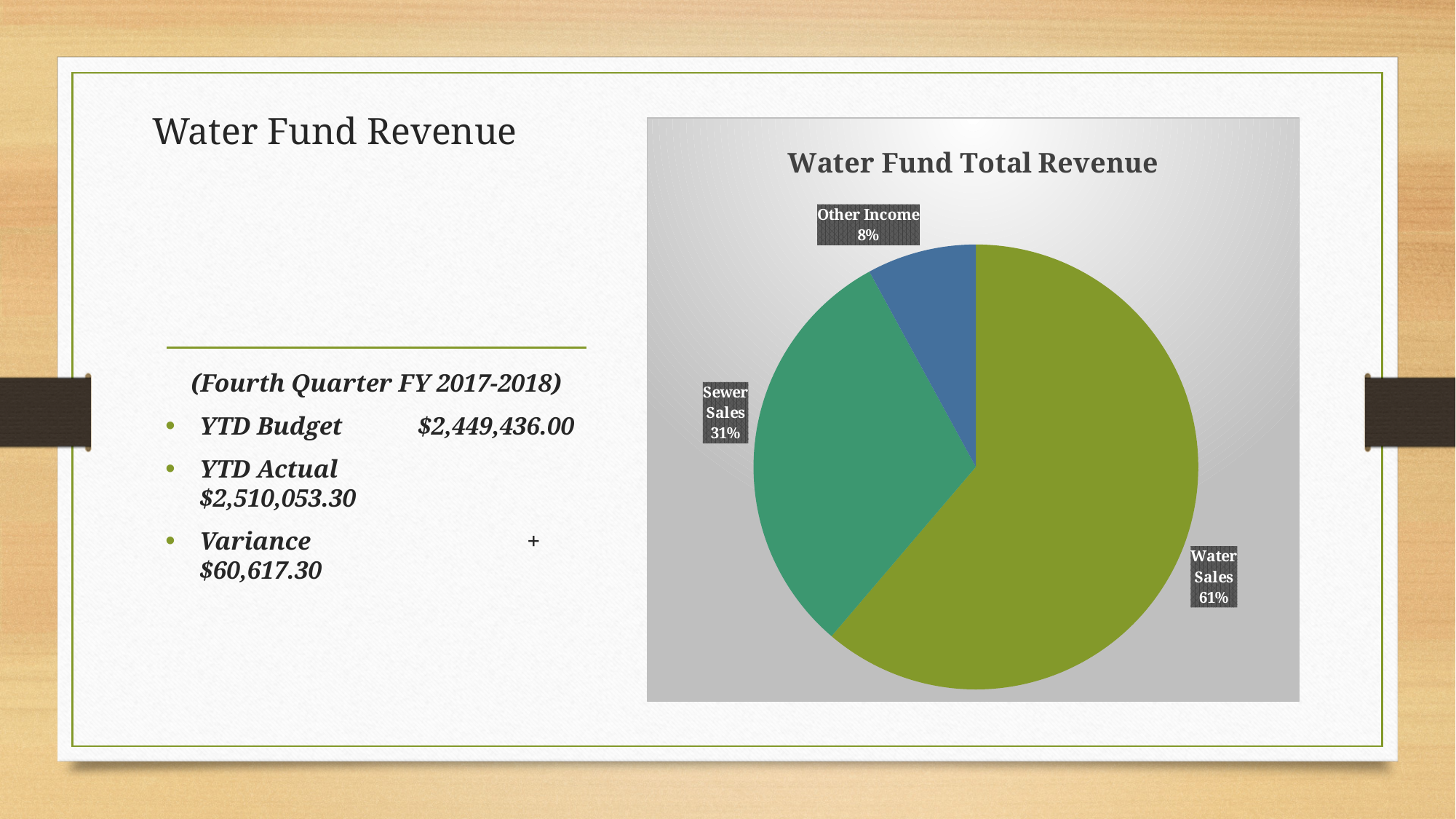
What share of the pie does Water Sales represent? 61% What is the difference in percentage points between Sewer Sales and Other Income? 23 How many slices does the pie chart have? 3 What share of the pie does Other Income represent? 8% Which category has the largest slice of the pie? Water Sales Which is larger, the Sewer Sales slice or the Other Income slice? Sewer Sales What is the difference in percentage points between Water Sales and Sewer Sales? 30 What share of the pie does Sewer Sales represent? 31% What type of chart is shown on the slide? Pie chart What colour is the Other Income slice? Blue Which category has the smallest slice of the pie? Other Income What is the title of the chart? Water Fund Total Revenue